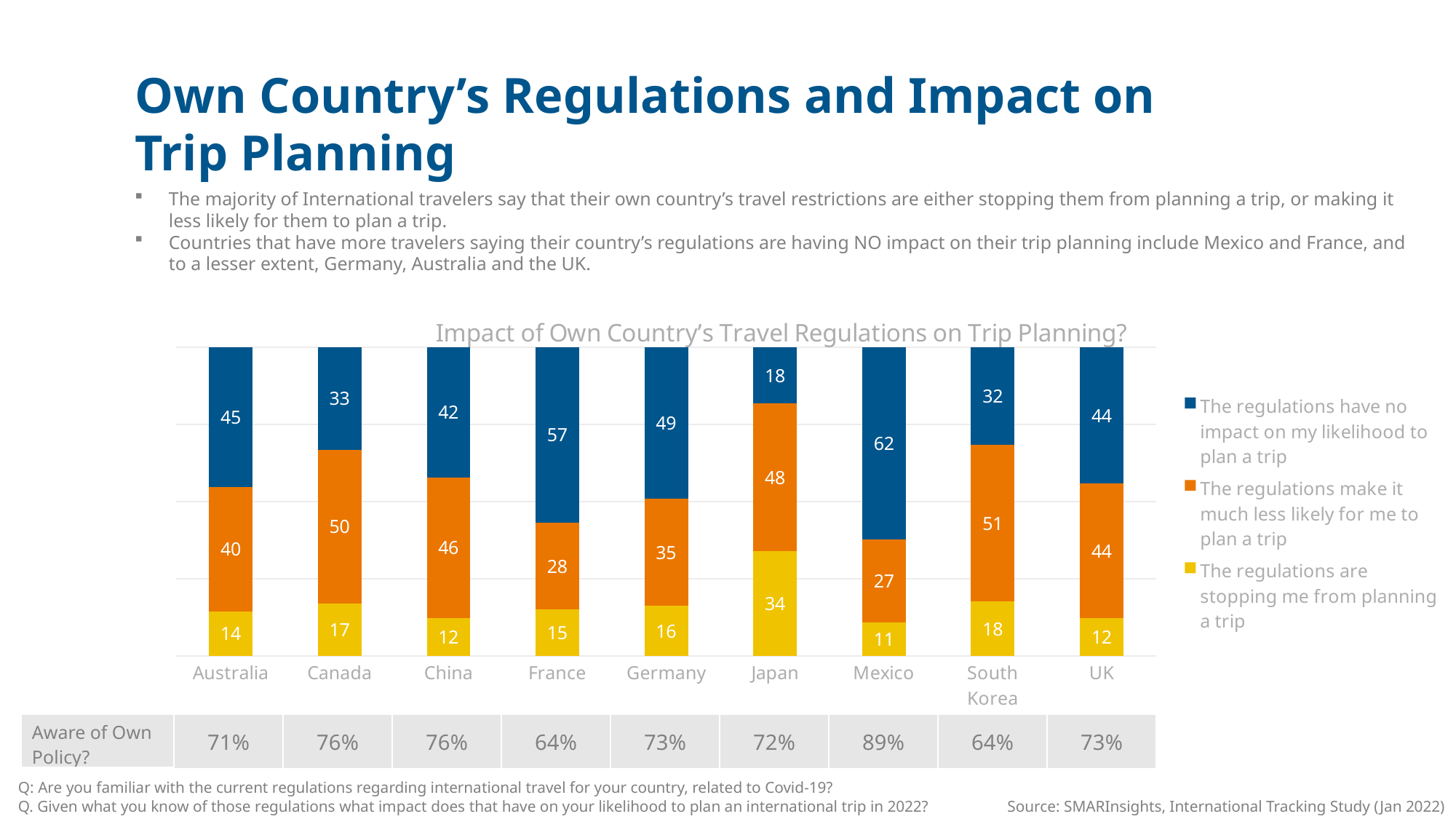
What kind of chart is shown on the slide? Stacked bar chart Which country has the lowest value for 'The regulations are stopping me from planning a trip'? Mexico What is the title of the chart? Impact of Own Country's Travel Regulations on Trip Planning? Which is larger for 'The regulations make it much less likely for me to plan a trip': China or Germany? China Which country has the highest value for 'The regulations are stopping me from planning a trip'? Japan Which country has the highest value for 'The regulations have no impact on my likelihood to plan a trip'? Mexico What is the total of the three stacked segments for Australia? 99 What is the difference between France's and Japan's values for 'The regulations have no impact on my likelihood to plan a trip'? 39 How many series does the chart's legend list? 3 What percentage of travelers from Japan say the regulations are stopping them from planning a trip? 34 How many countries are shown on the x axis of the chart? 9 What is the value for Mexico in the series 'The regulations make it much less likely for me to plan a trip'? 27